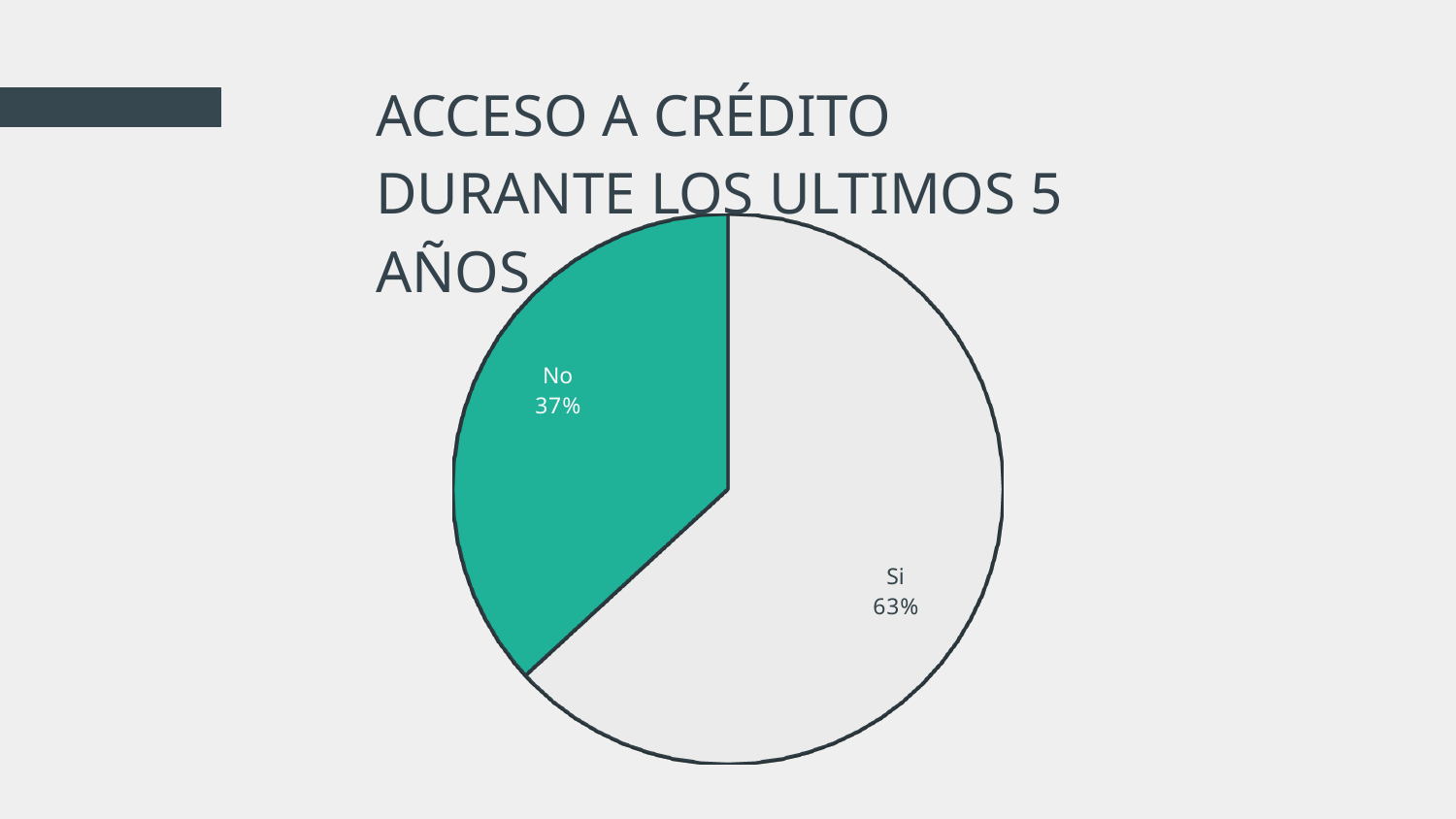
How many slices does the pie chart have? 2 What colour is the "No" slice of the pie? green Which slice of the pie is the largest? Si Which is larger, the "Si" slice or the "No" slice? Si What kind of chart is shown on the slide? pie chart What is the title of the chart on the slide? ACCESO A CRÉDITO DURANTE LOS ULTIMOS 5 AÑOS What percentage of the pie is labelled "Si"? 63% What is the difference in percentage points between the "Si" slice and the "No" slice? 26 Which slice of the pie is the smallest? No What share of the pie does the "No" slice represent? 37% What percentage of the pie is labelled "No"? 37%